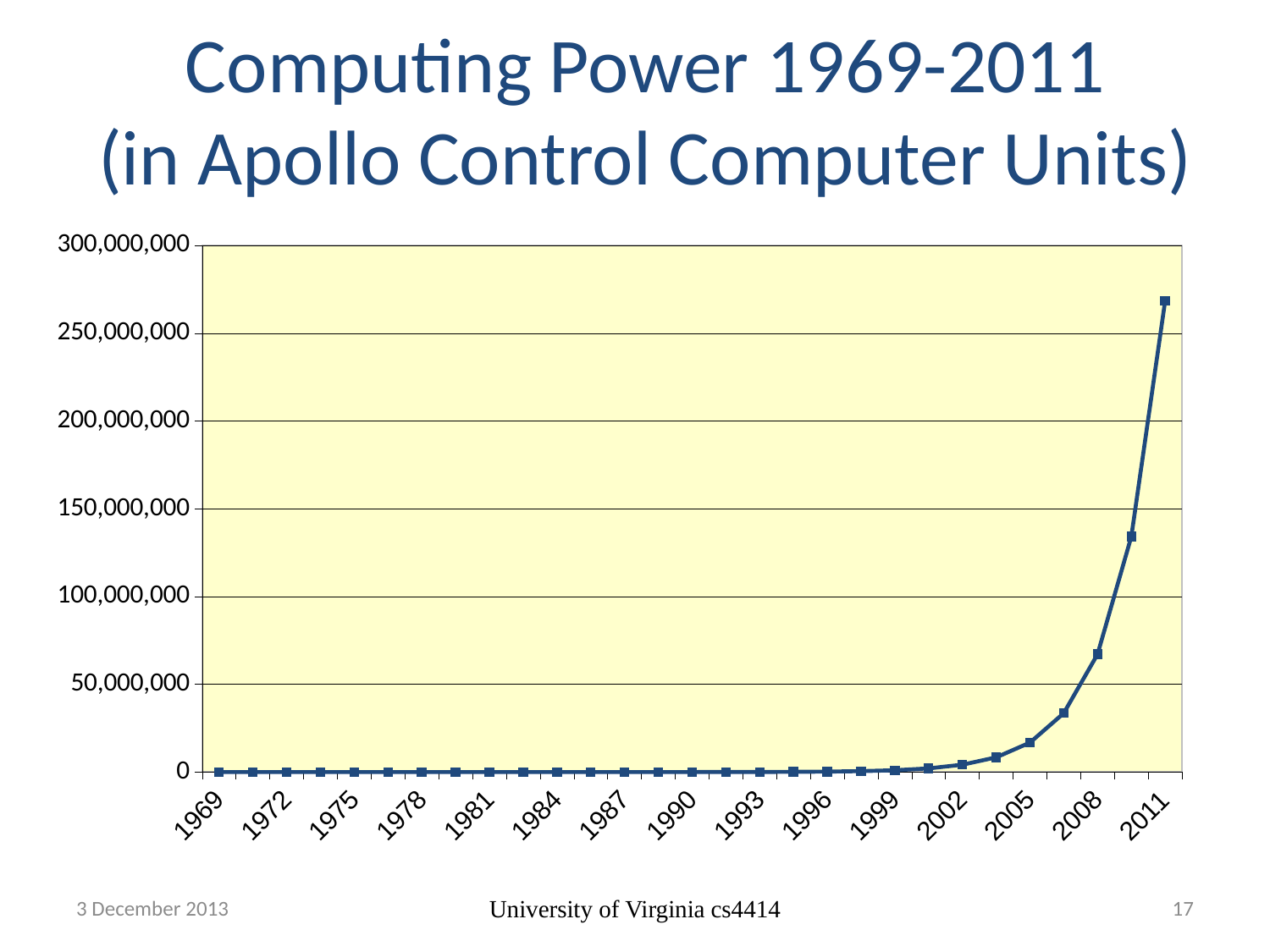
How many year labels are shown on the x axis? 15 Do the values generally rise or fall from 1969 to 2011? rise Is the value for 1999 greater or less than 50,000,000? less Which year has the highest computing power value on the chart? 2011 Is the value for 2008 greater or less than 50,000,000? greater What is the title of the chart? Computing Power 1969-2011 (in Apollo Control Computer Units) What is the highest value shown on the y axis? 300,000,000 Is the value for 2011 greater or less than 250,000,000? greater Which year has the larger value, 2008 or 2011? 2011 What kind of chart is shown on the slide? line chart